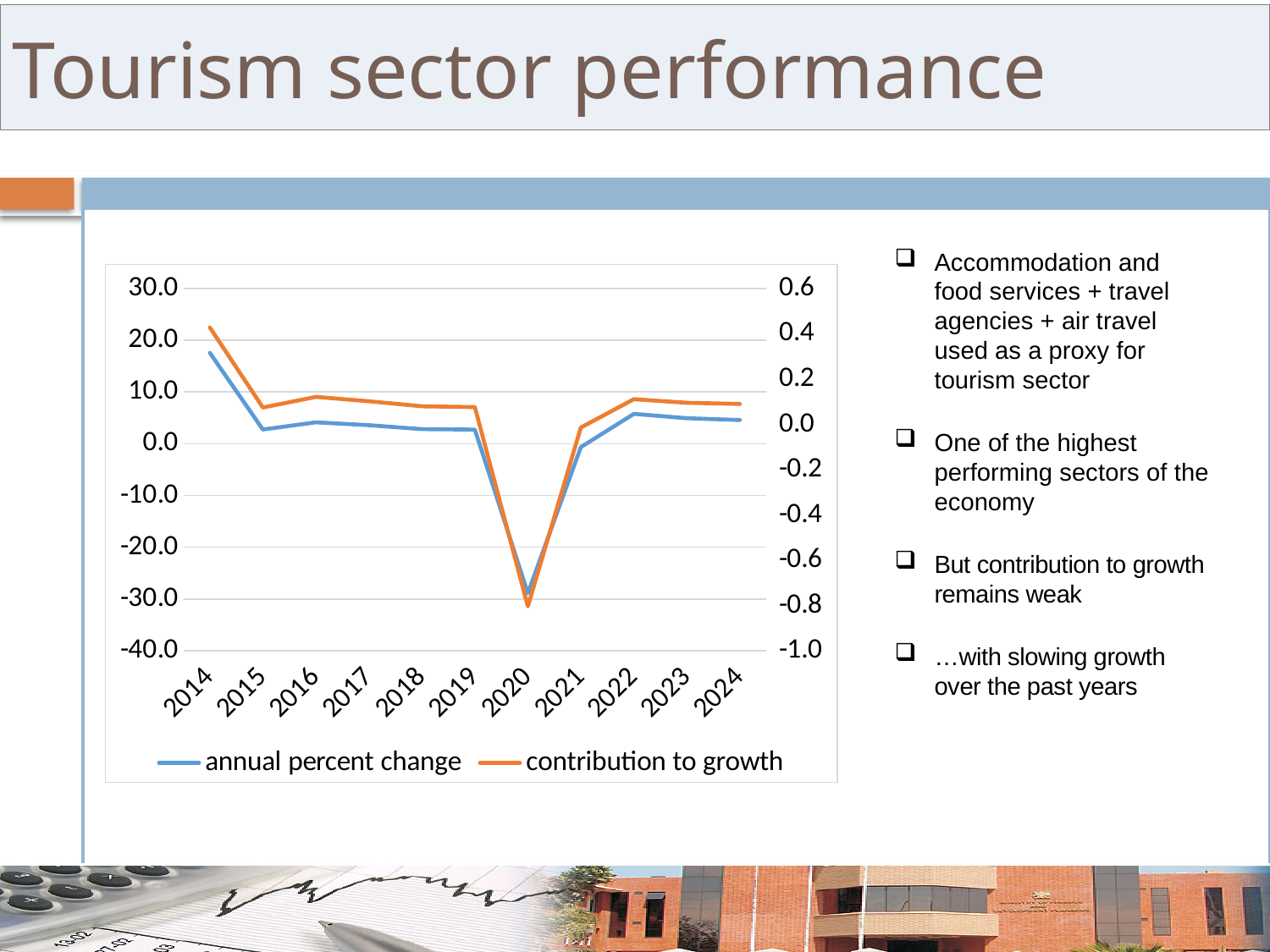
Does the annual percent change rise or fall from 2014 to 2015? fall What are the two series named in the chart's legend? annual percent change; contribution to growth In which year is the contribution to growth at its lowest? 2020 Is the contribution to growth for 2014 greater or less than 0.2? greater In which year is the annual percent change at its highest? 2014 Which year has the larger annual percent change, 2014 or 2022? 2014 What kind of chart is shown on the slide? line chart How many series does the chart's legend list? 2 In which year is the annual percent change at its lowest? 2020 Is the annual percent change for 2014 greater or less than 10.0? greater How many years are plotted along the x axis of the chart? 11 Is the annual percent change for 2020 greater or less than -20.0? less